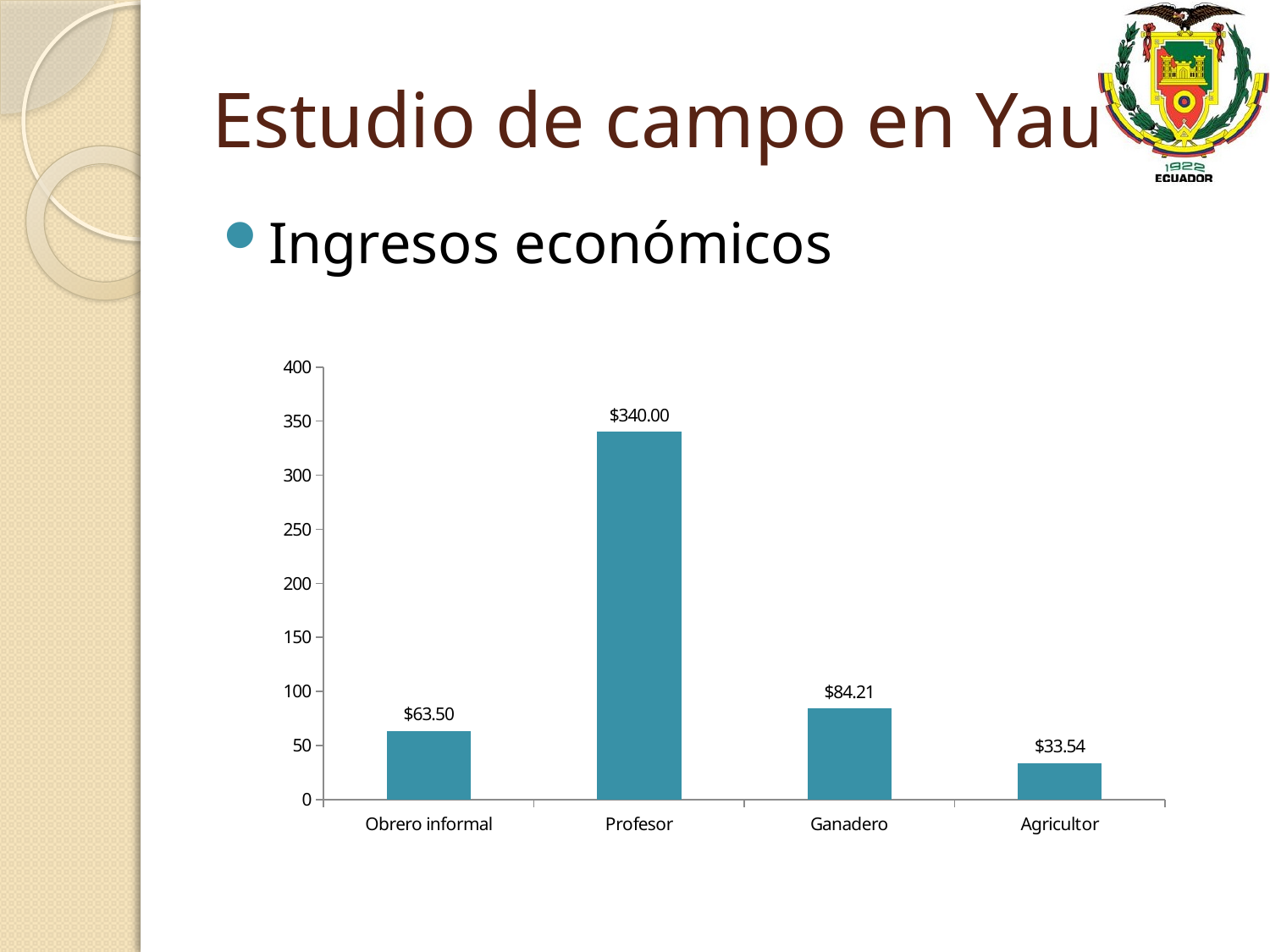
Which category has the lowest value? Agricultor What kind of chart is shown on the slide? bar chart Is the value for Ganadero greater or less than 100? less Which category has the highest value? Profesor What is the difference between the values for Ganadero and Obrero informal? $20.71 How many categories are shown on the x axis? 4 What is the value for Agricultor? $33.54 What is the difference between the values for Profesor and Ganadero? $255.79 What is the value for Ganadero? $84.21 What is the value for Profesor? $340.00 What is the value for Obrero informal? $63.50 Which is larger, the value for Obrero informal or the value for Agricultor? Obrero informal